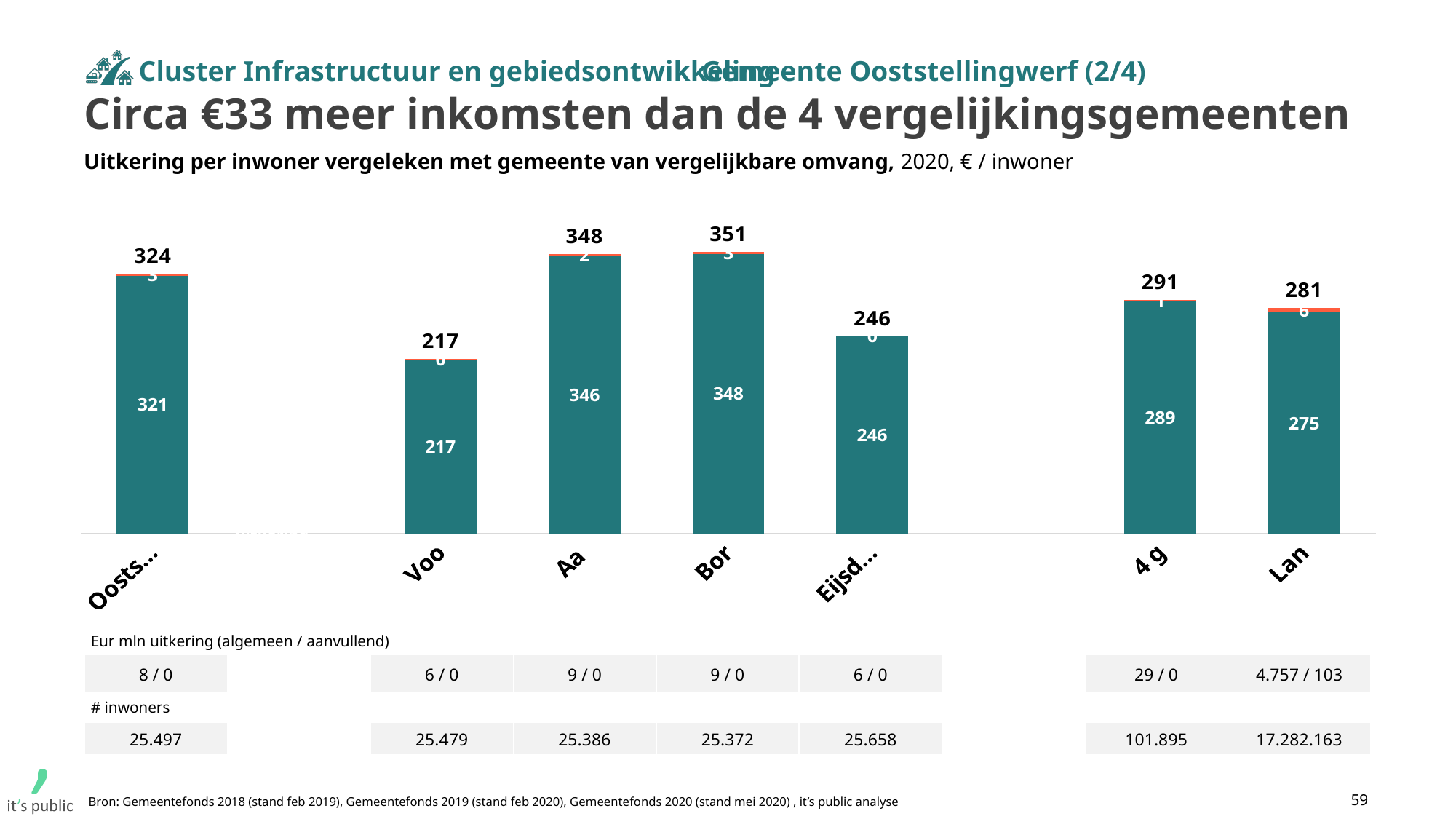
What is the total value shown above the bar for 4 g? 291 Which has a larger total value, 4 g or Lan? 4 g What is the total value shown above the bar for Bor? 351 What unit is stated in the chart subtitle for the plotted values? € / inwoner What is the value of the teal segment in the bar for Lan? 275 How many bars are plotted in the chart? 7 What is the difference between the total values for Aa and Voo? 131 Which category has the highest total value? Bor What kind of chart is shown on the slide? Stacked bar chart What is the total value shown above the bar for Voo? 217 What is the difference between the total values for the first bar (Oosts...) and 4 g? 33 Which category has the lowest total value? Voo